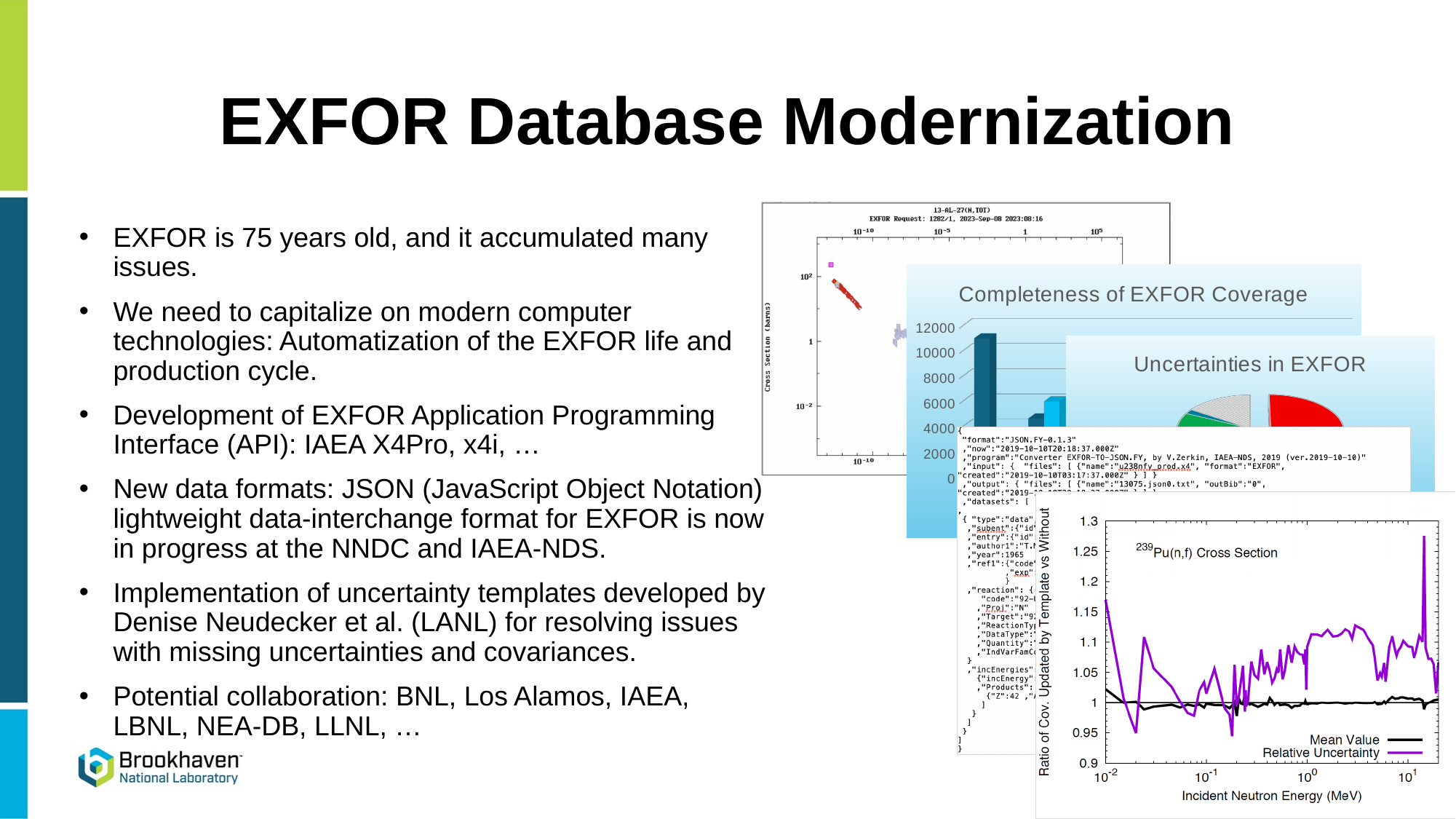
In the "239Pu(n,f) Cross Section" chart, at an incident neutron energy of 10^1 MeV, which series has the larger value, Mean Value or Relative Uncertainty? Relative Uncertainty In the "239Pu(n,f) Cross Section" chart, which series is plotted in purple? Relative Uncertainty In the "239Pu(n,f) Cross Section" chart, is the highest peak of the Relative Uncertainty series greater or less than 1.2? greater How many series does the legend of the "239Pu(n,f) Cross Section" chart list? 2 In the "239Pu(n,f) Cross Section" chart, is the Relative Uncertainty value at the lowest incident neutron energy (10^-2 MeV) greater or less than 1.1? greater What kind of chart is the "Uncertainties in EXFOR" chart? pie chart What kind of chart is the "239Pu(n,f) Cross Section" chart at the bottom right of the slide? line chart What is the x-axis label of the "239Pu(n,f) Cross Section" chart? Incident Neutron Energy (MeV) In the "239Pu(n,f) Cross Section" chart, is the Mean Value series at 10^0 MeV greater or less than 1.05? less What kind of chart is the "Completeness of EXFOR Coverage" chart? bar chart